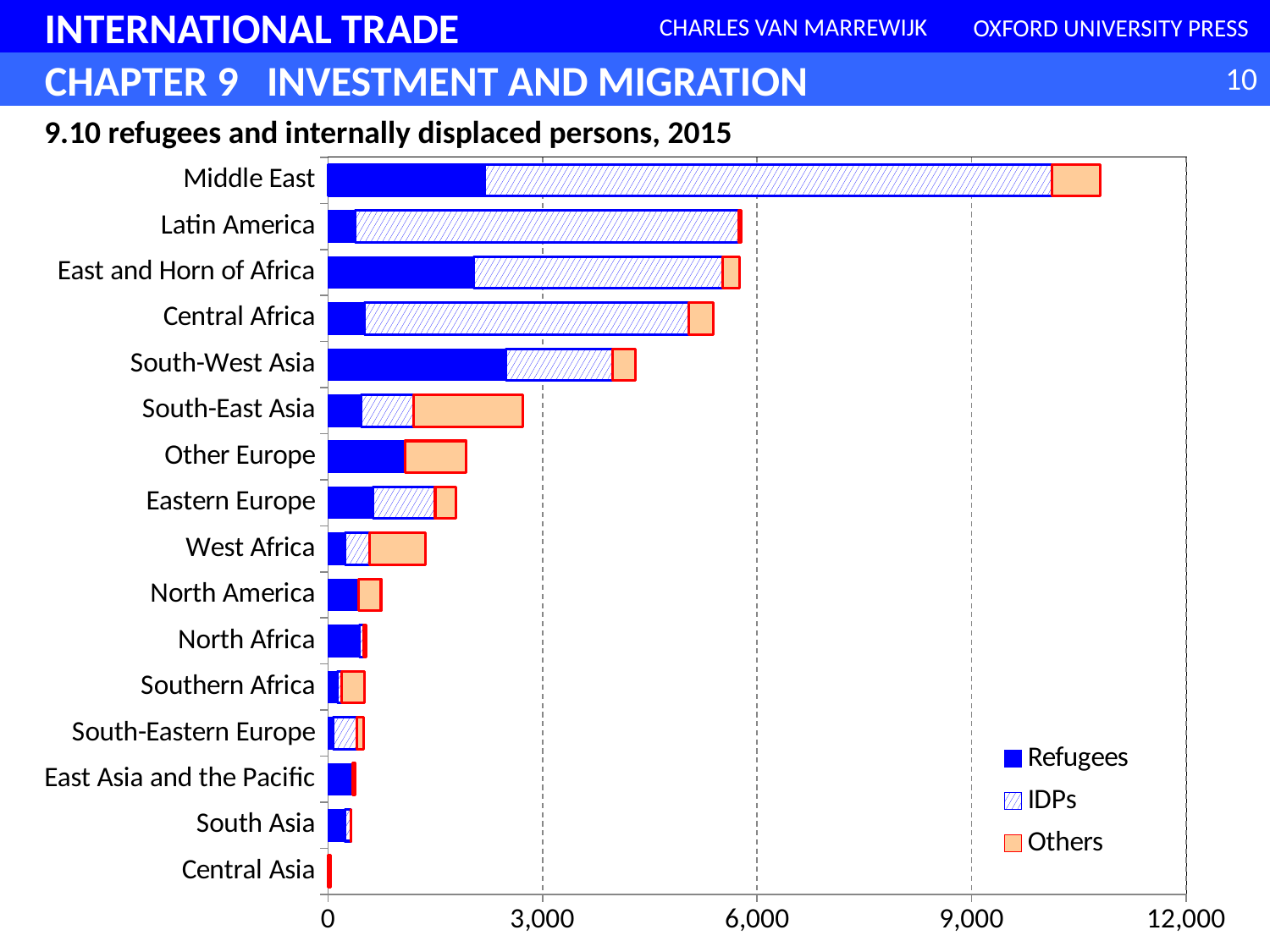
Which has the longer total bar, Central Africa or South-West Asia? Central Africa What kind of chart is shown on the slide? Stacked bar chart Which region has the longest total bar? Middle East Is the total bar for South-West Asia greater or less than 3,000? greater What are the three series named in the legend? Refugees, IDPs, Others Is the total bar for Middle East greater or less than 9,000? greater Which region has the largest Others segment? South-East Asia How many regions are listed on the vertical axis of the chart? 16 Is the Refugees segment for Middle East greater or less than 3,000? less Which region has the shortest total bar? Central Asia How many series does the legend list? 3